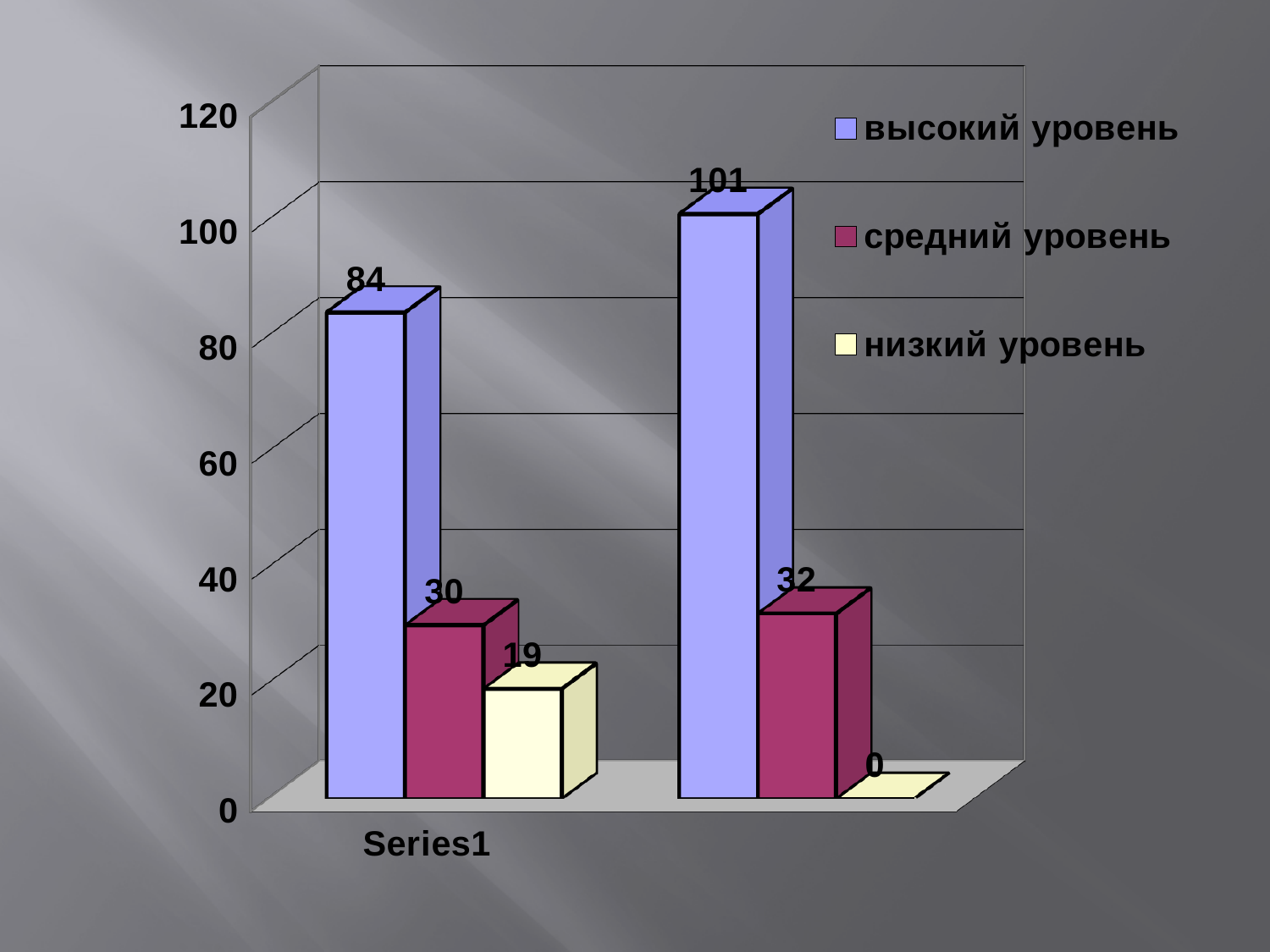
What is the value of the средний уровень bar in the Series1 group? 30 What is the value of the низкий уровень bar in the right-hand (unlabeled) group? 0 What is the value of the низкий уровень bar in the Series1 group? 19 How many series does the legend list? 3 What is the difference between the высокий уровень values of the right-hand group and the Series1 group? 17 Which series has the lowest value in the right-hand (unlabeled) group? низкий уровень Which is larger: the средний уровень value in the Series1 group or in the right-hand group? the right-hand group What kind of chart is shown on the slide? bar chart Which series has the highest value in the Series1 group? высокий уровень Is the высокий уровень value in the right-hand group greater or less than 100? greater What is the value of the высокий уровень bar in the Series1 group? 84 What is the value of the высокий уровень bar in the right-hand (unlabeled) group? 101